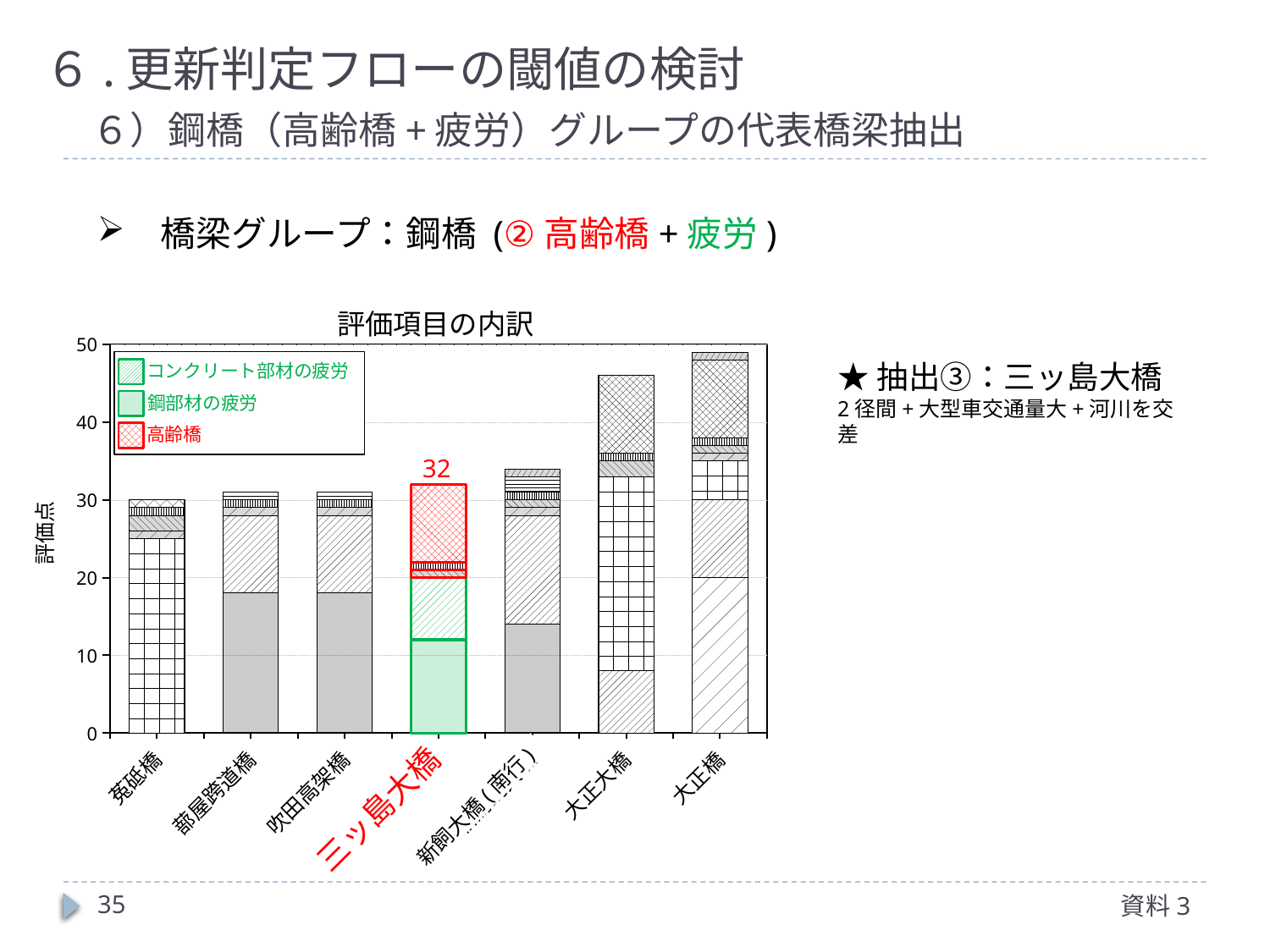
What is the total score (評価点) labelled for 三ッ島大橋? 32 Is the total score for 新飼大橋(南行) greater or less than 30? greater How many series does the chart's legend list? 3 How many bridges (categories) are shown on the x axis of the chart? 7 What kind of chart is shown on the slide? bar chart Which has the larger total score, 新飼大橋(南行) or 菟砥橋? 新飼大橋(南行) Is the total score for 大正大橋 greater or less than 40? greater What is the title of the chart? 評価項目の内訳 Which bridge has the highest total score in the chart? 大正橋 Which category label on the x axis is highlighted in red? 三ッ島大橋 Is the total score for 菟砥橋 greater or less than 40? less Which has the larger total score, 大正大橋 or 三ッ島大橋? 大正大橋